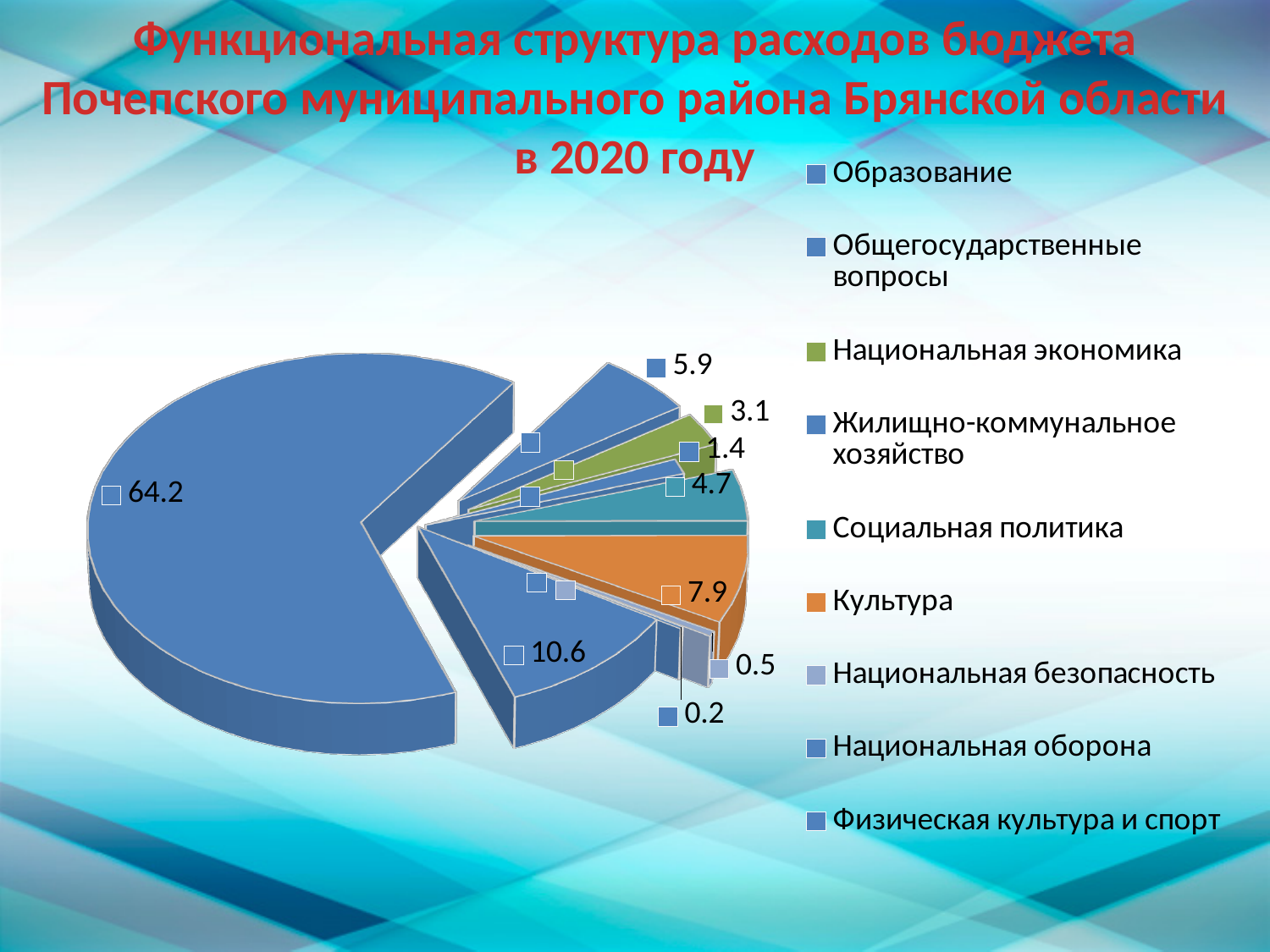
Which is larger, the value for Культура or the value for Национальная экономика? Культура What value is shown for Социальная политика? 4.7 What value is shown for Национальная безопасность? 0.5 What value is shown for Национальная экономика? 3.1 Which category has the largest slice in the pie chart? Образование What is the smallest value labelled on the pie chart? 0.2 How many slices does the pie chart have? 9 What value is shown for the largest slice (Образование)? 64.2 What value is shown for Культура? 7.9 What colour is the Культура slice in the pie chart? Orange What is the difference between the values for Культура and Социальная политика? 3.2 What kind of chart is shown on the slide? Pie chart